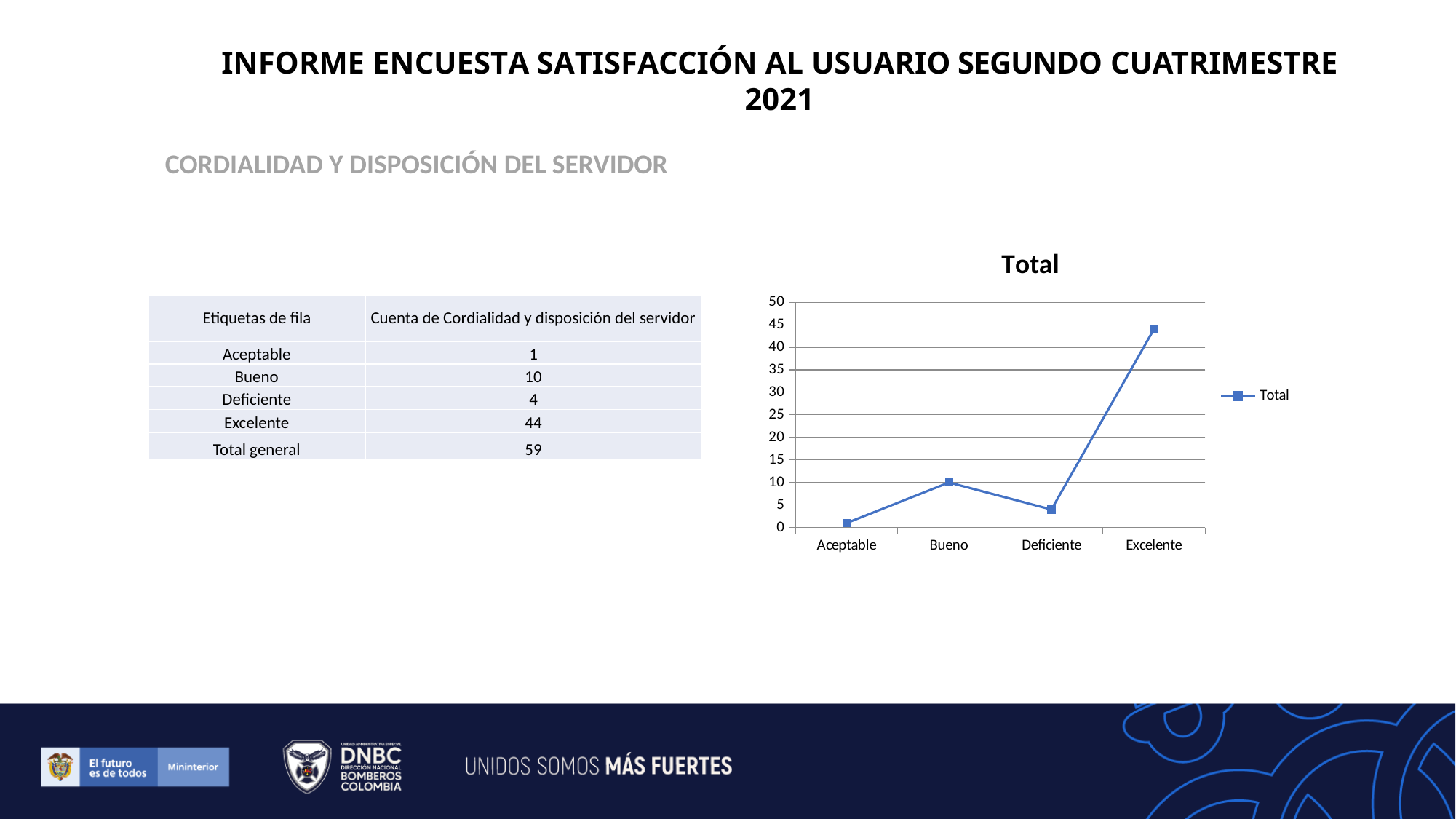
What is the value for Bueno in the chart? 10 How many categories are plotted on the x axis of the chart? 4 Which category has the lowest value in the chart? Aceptable Which category has the highest value in the chart? Excelente What is the difference between the values for Excelente and Bueno? 34 What is the value for Deficiente in the chart? 4 What type of chart is shown on the slide? line chart What is the title of the chart? Total What is the value for Excelente in the chart? 44 How many series does the chart legend list? 1 Is the value for Excelente greater or less than 40? greater Which is larger, the value for Bueno or the value for Deficiente? Bueno